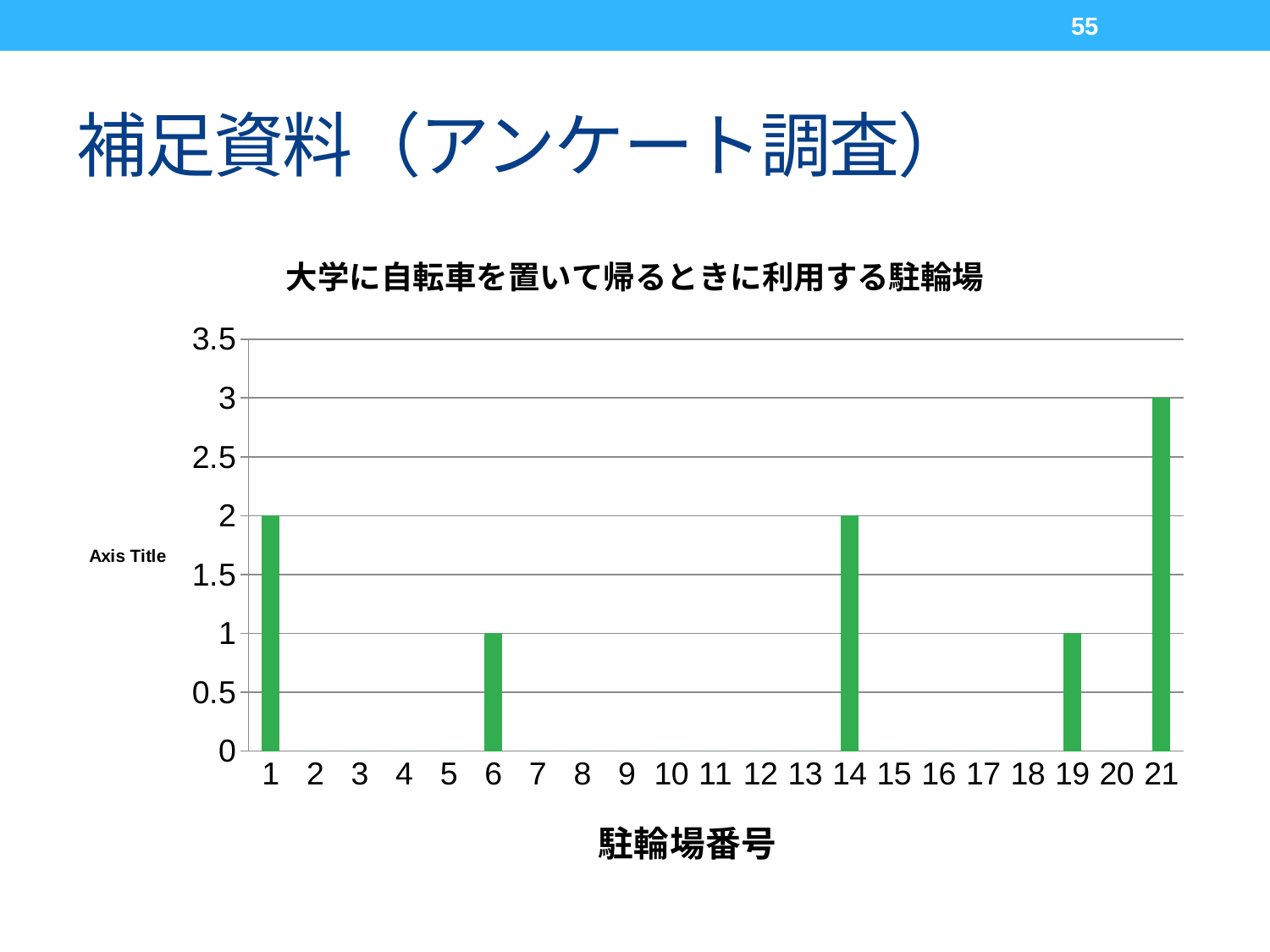
Which 駐輪場番号 has the highest value? 21 What is the value for 駐輪場番号 21? 3 What is the value for 駐輪場番号 14? 2 What is the value for 駐輪場番号 1? 2 What kind of chart is shown on the slide? bar chart What is the label of the x axis? 駐輪場番号 Is the value for 駐輪場番号 21 greater or less than 2.5? greater What is the difference between the values for 駐輪場番号 21 and 駐輪場番号 19? 2 What is the value for 駐輪場番号 6? 1 How many categories are shown on the x axis? 21 Which has a larger value, 駐輪場番号 14 or 駐輪場番号 19? 14 What is the title of the chart? 大学に自転車を置いて帰るときに利用する駐輪場